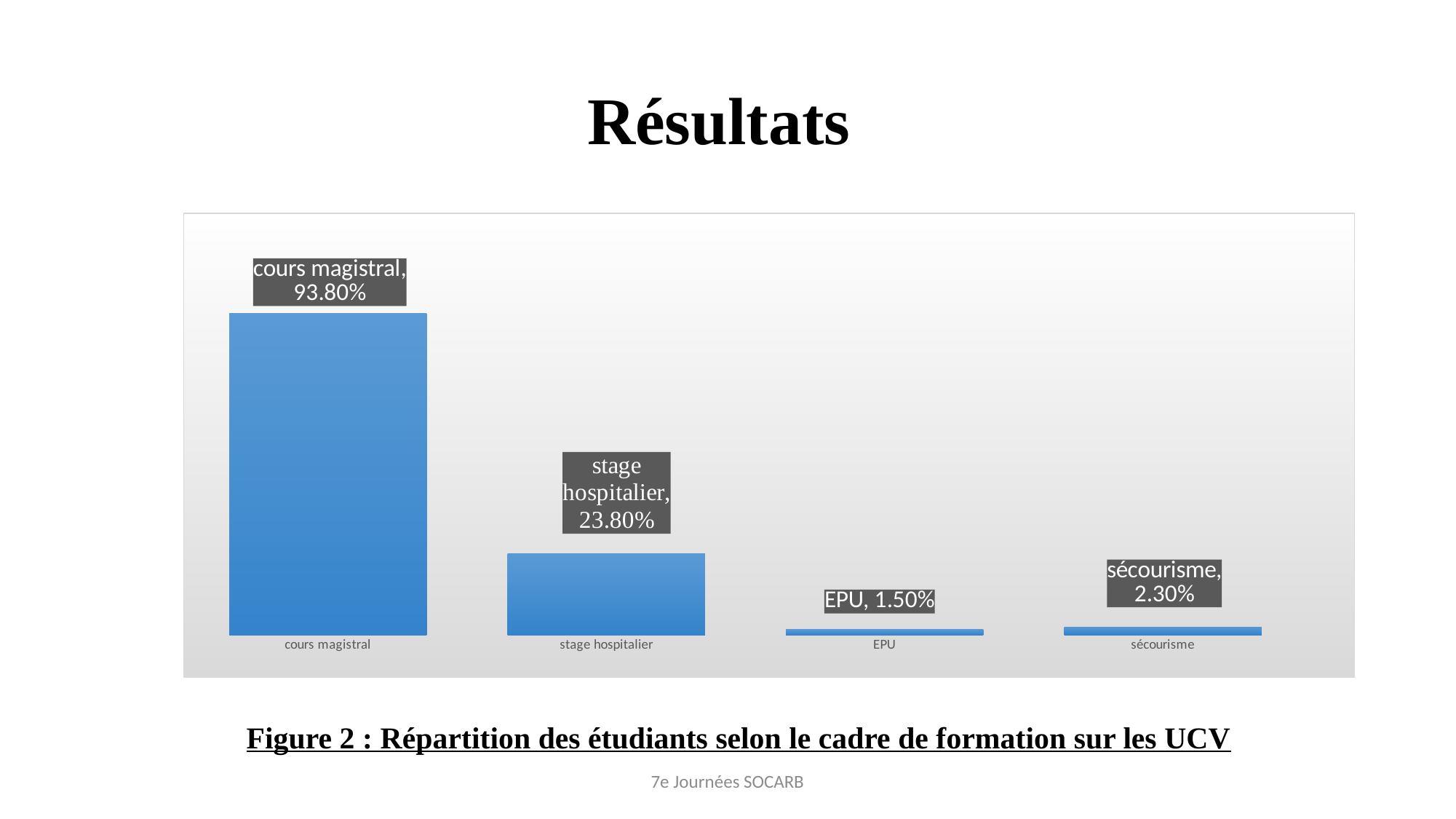
What is the difference between the values for cours magistral and stage hospitalier? 70.00% What kind of chart is shown on the slide? bar chart How many categories are shown in the chart? 4 What is the value for stage hospitalier? 23.80% What is the value for sécourisme? 2.30% What is the difference between the values for sécourisme and EPU? 0.80% Which category has the highest value? cours magistral What is the caption of the figure below the chart? Figure 2 : Répartition des étudiants selon le cadre de formation sur les UCV Which is larger, the value for sécourisme or the value for EPU? sécourisme Which category has the lowest value? EPU What is the value for EPU? 1.50% What is the value for cours magistral? 93.80%